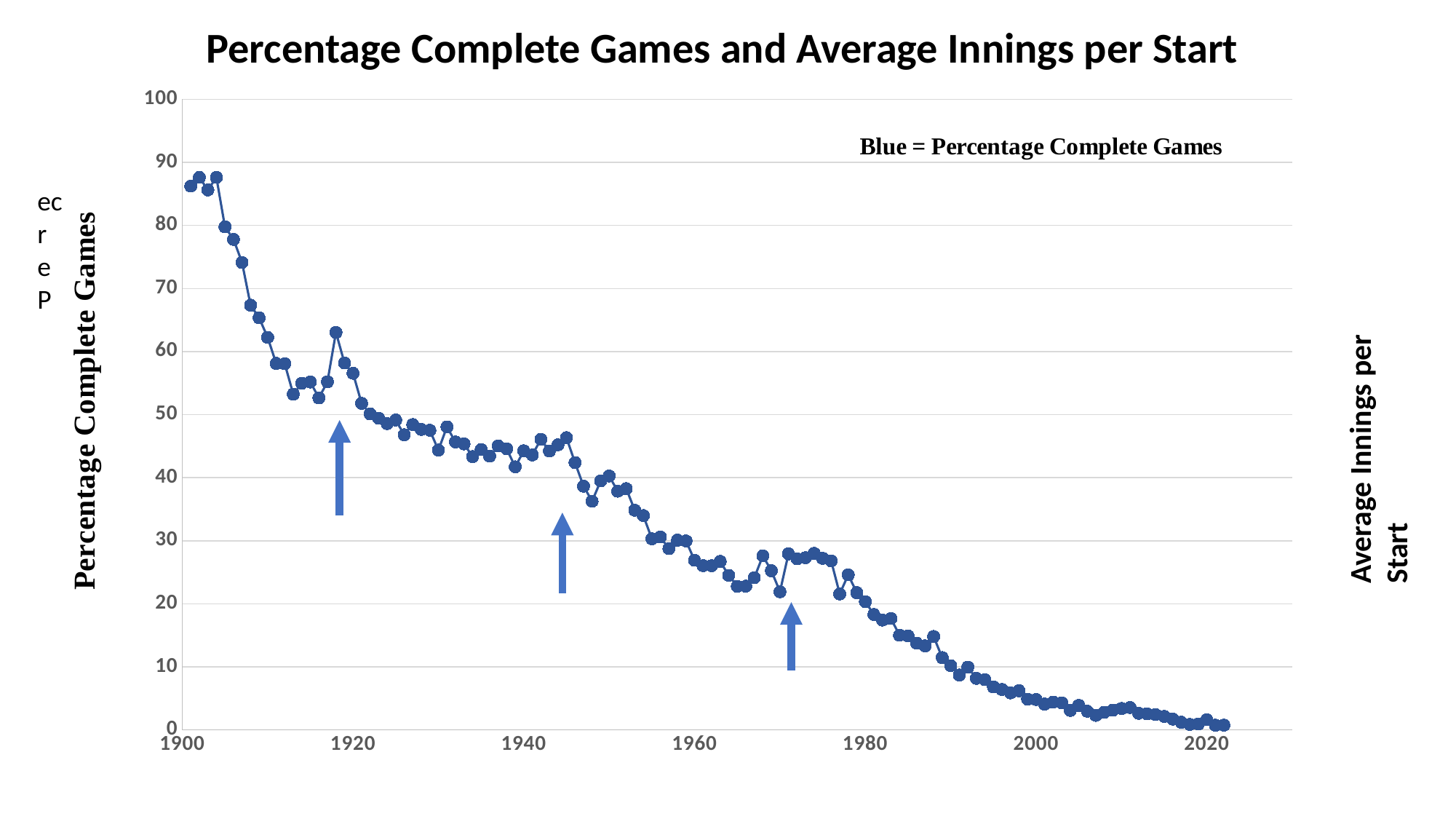
Is the percentage of complete games in 2020 greater or less than 10? less Is the percentage of complete games in 1900 greater or less than 80? greater According to the note on the chart, what does the blue line represent? Percentage Complete Games Is the percentage of complete games in 1960 greater or less than 40? less Which year has the higher percentage of complete games, 1910 or 1950? 1910 What is the highest value shown on the left vertical axis? 100 What is the title of the chart? Percentage Complete Games and Average Innings per Start What kind of chart is shown on the slide? line chart Overall, do the values of the blue line rise or fall as the years go from 1900 to 2020? fall Which year has the higher percentage of complete games, 1920 or 1980? 1920